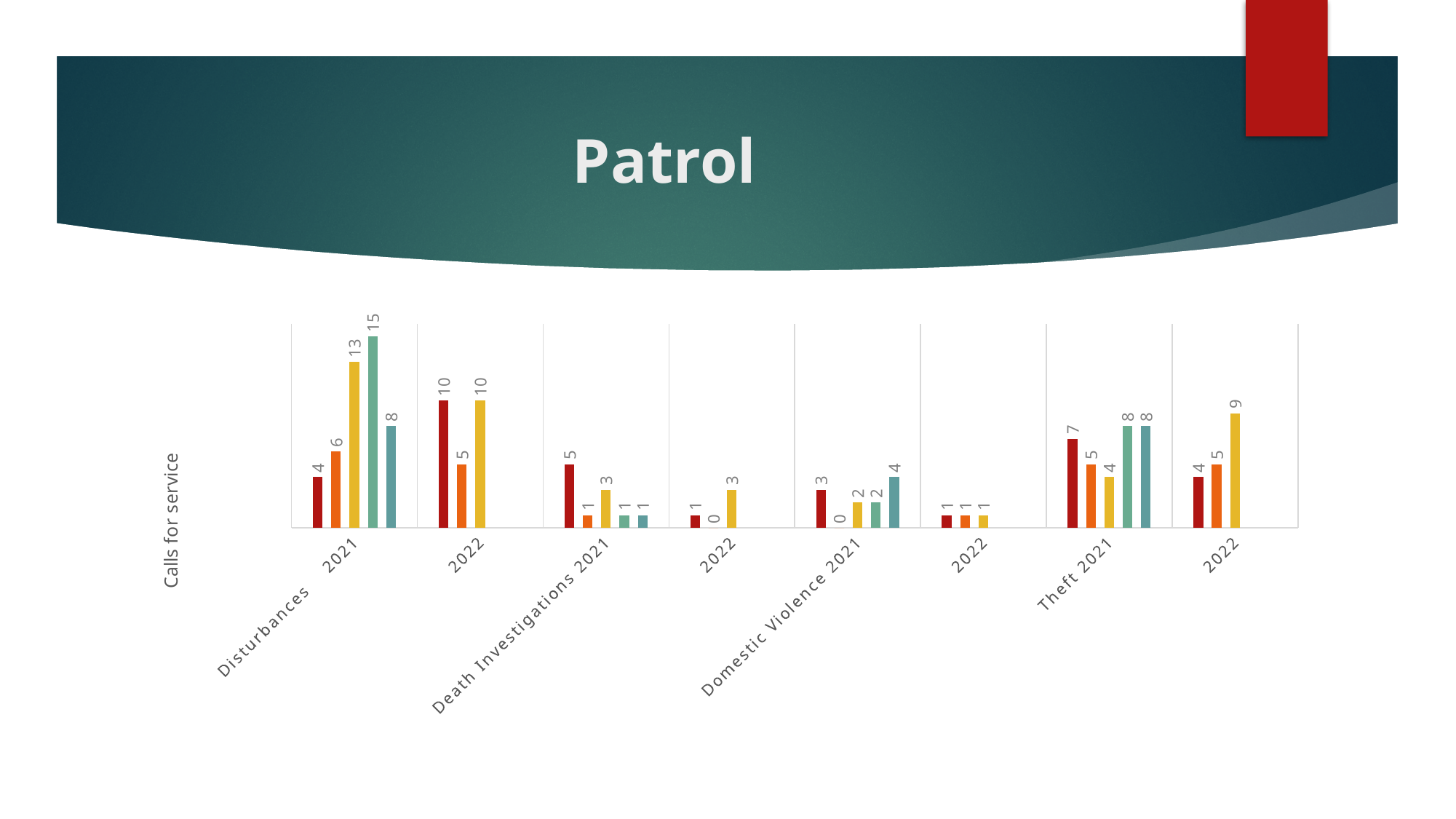
In which category group does the tallest bar (15) appear? Disturbances 2021 What is the difference between the tallest bar (15) and the dark red bar (4) in the Disturbances 2021 group? 11 How many category groups are shown along the x axis of the chart? 8 What is the label on the vertical axis of the chart? Calls for service What is the value of the dark red bar for Disturbances 2022? 10 What is the value of the yellow bar for Theft 2022? 9 What kind of chart is shown on the slide? bar chart Which is larger: the yellow bar for Theft 2021 or the yellow bar for Theft 2022? Theft 2022 What is the value of the yellow bar for Disturbances 2021? 13 What is the value of the dark red bar for Theft 2021? 7 What is the value of the orange bar for Death Investigations 2022? 0 What is the highest value labelled on any bar in the chart? 15